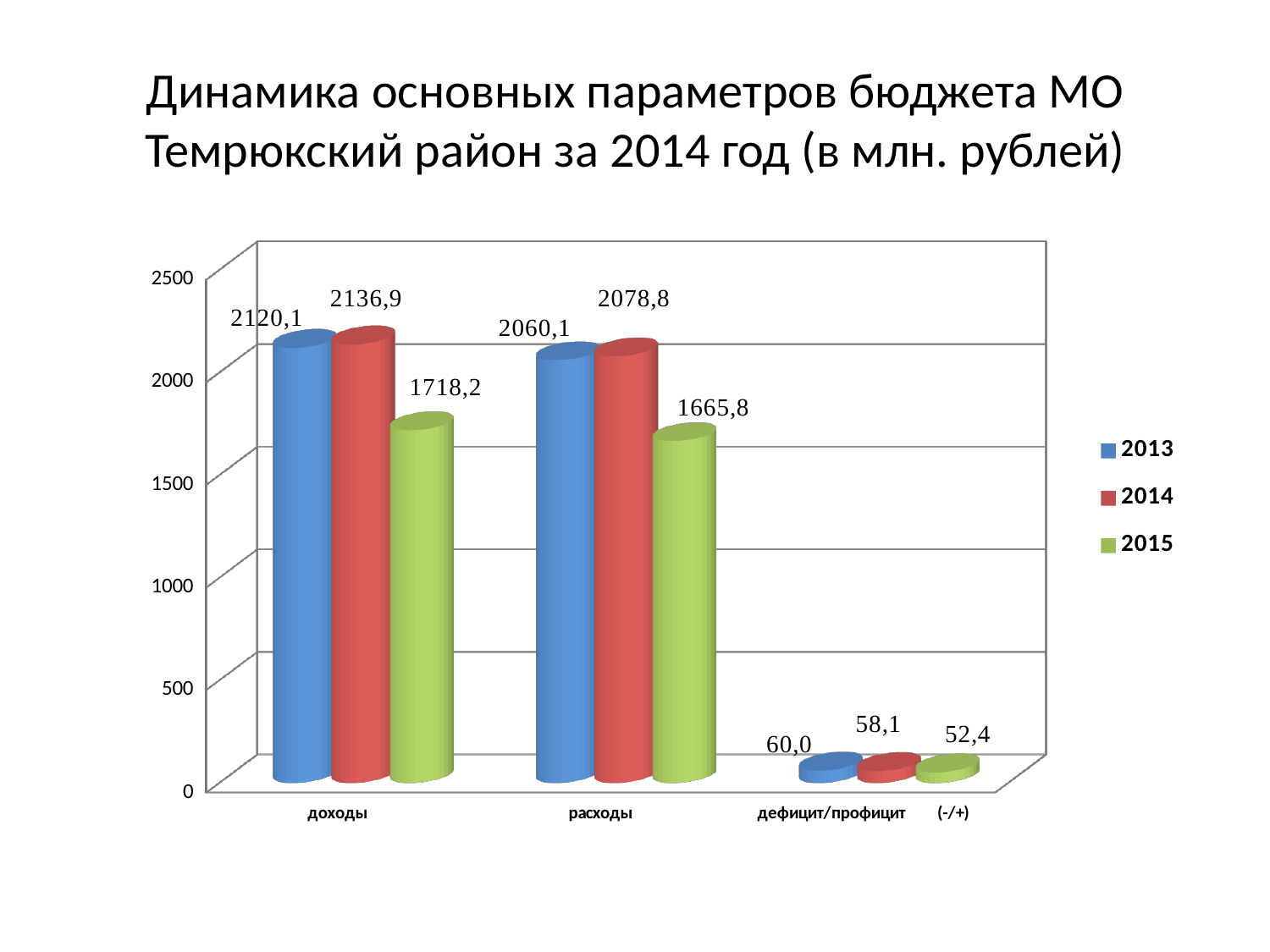
Which is larger: доходы in 2013 or расходы in 2014? доходы in 2013 Which year has the lowest value for расходы? 2015 What is the difference between the 2014 and 2015 values for расходы? 413,0 What kind of chart is shown on the slide? bar chart Which year has the highest value for доходы? 2014 What is the value for доходы in 2015? 1718,2 How many categories are shown on the x axis? 3 What is the difference between доходы and расходы in 2013? 60,0 What is the value for расходы in 2014? 2078,8 What is the value for дефицит/профицит (-/+) in 2013? 60,0 How many series does the legend list? 3 Is the value for доходы in 2015 greater or less than 2000? less